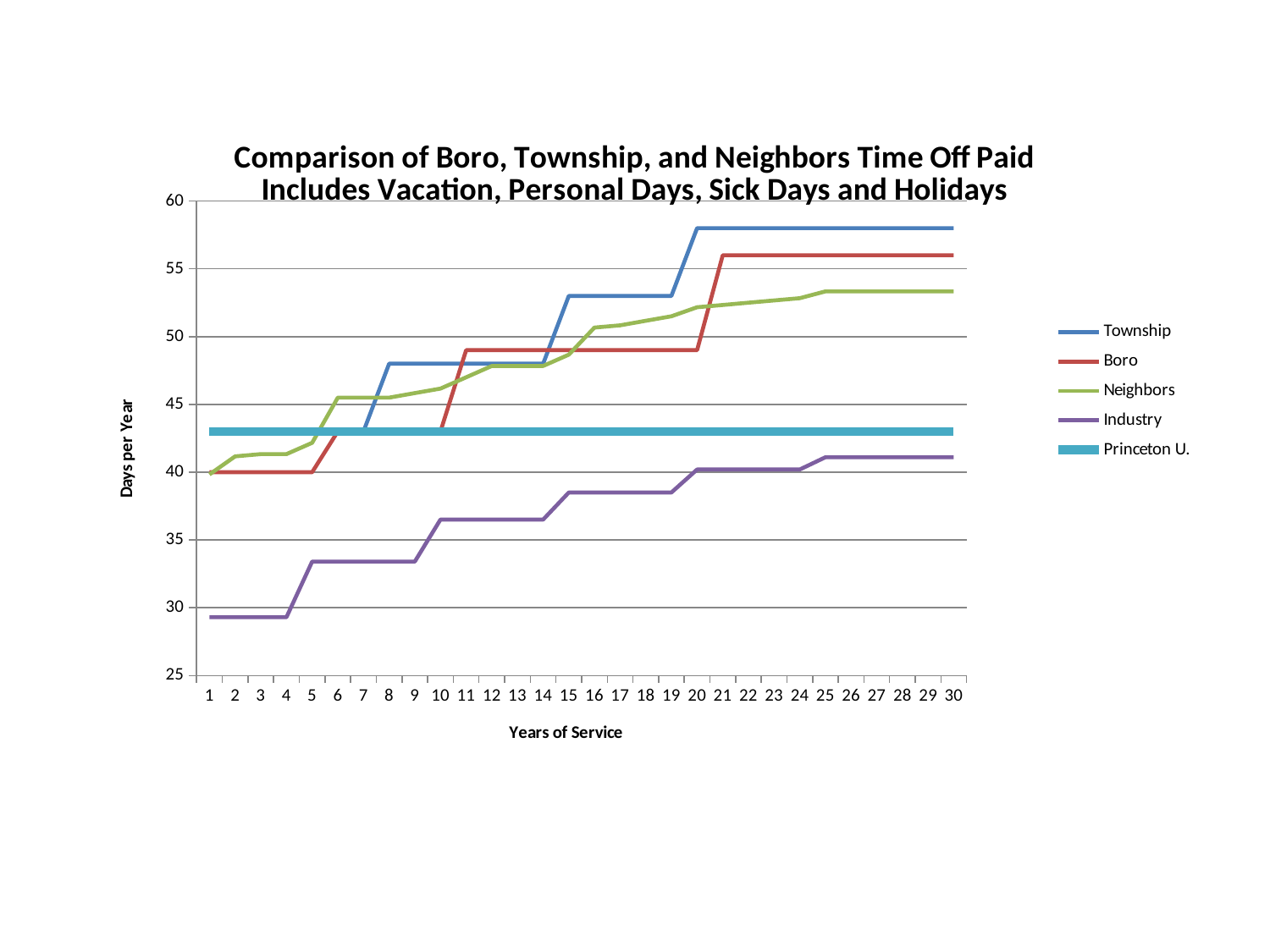
At year 30, which is larger, Boro or Neighbors? Boro At year 10, which is larger, Township or Boro? Township What kind of chart is shown on the slide? line chart Does the Industry line rise or fall as years of service increase? rise How many years of service are shown along the x axis? 30 How many series does the legend list? 5 Is the value for Township at year 30 greater or less than 55? greater Is the value for Industry at year 1 greater or less than 30? less What is the label on the y axis? Days per Year Which series has the highest value at year 30? Township Which series has the lowest value at year 30? Industry Is the value for Princeton U. greater or less than 45? less